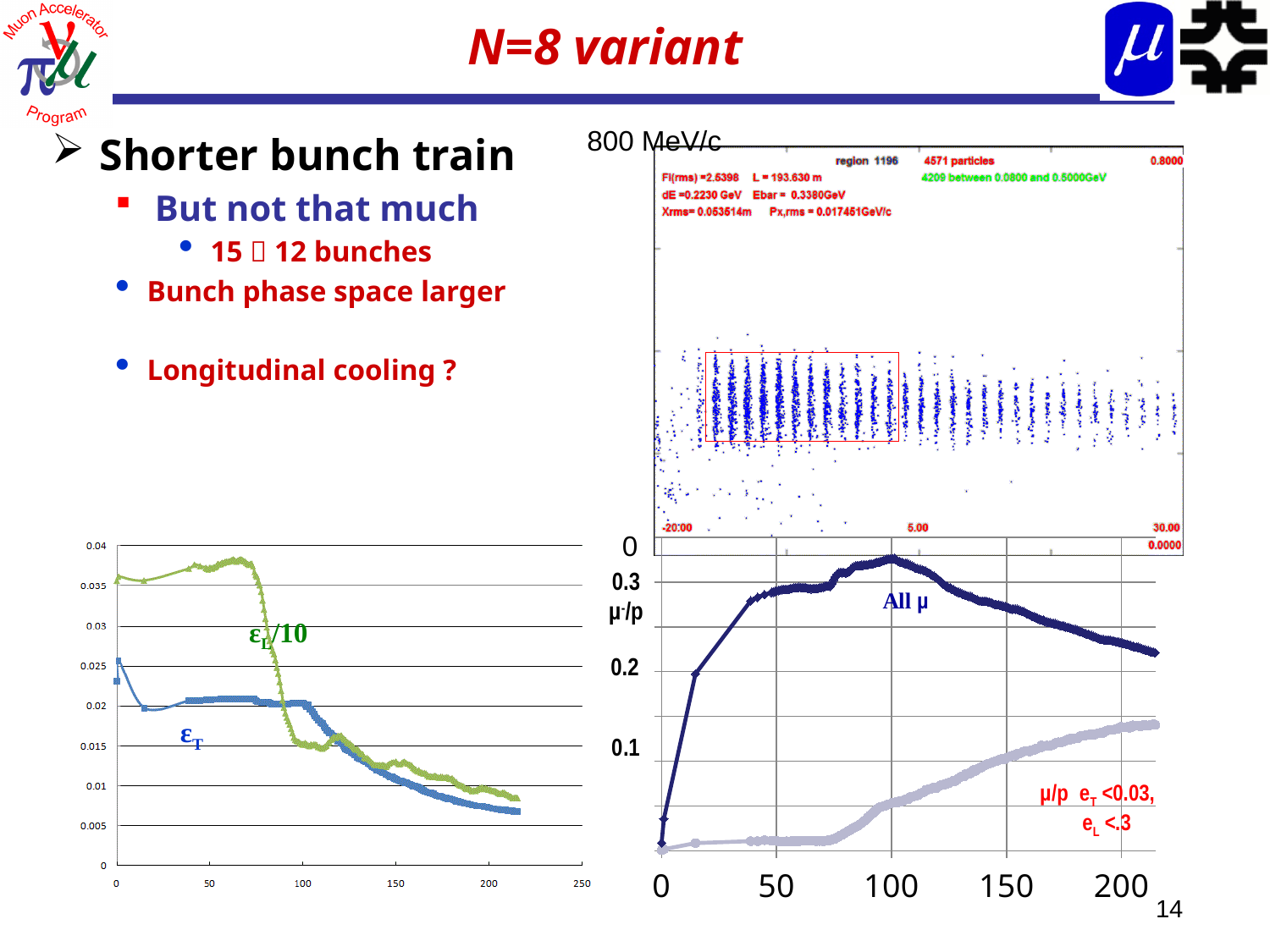
In the bottom-right chart, is the value of All μ at x=200 greater or less than 0.3? less In the bottom-left chart, which series is higher at x=50, εL/10 or εT? εL/10 In the bottom-right chart, does the μ/p (eT<0.03, eL<.3) series rise or fall along the x axis from 0 to 200? rise What kind of chart is the bottom-left chart showing εL/10 and εT? line chart In the top-right scatter plot, what is the value of L shown in the header? 193.630 m In the bottom-left chart, is the value of εT at x=200 greater or less than 0.01? less In the bottom-right chart, is the value of the μ/p (eT<0.03, eL<.3) series at x=200 greater or less than 0.1? greater In the top-right scatter plot, how many particles are reported in region 1196? 4571 particles In the bottom-left chart, do the εT values rise or fall overall along the x axis from 0 to 200? fall In the bottom-left chart, how many series are plotted? 2